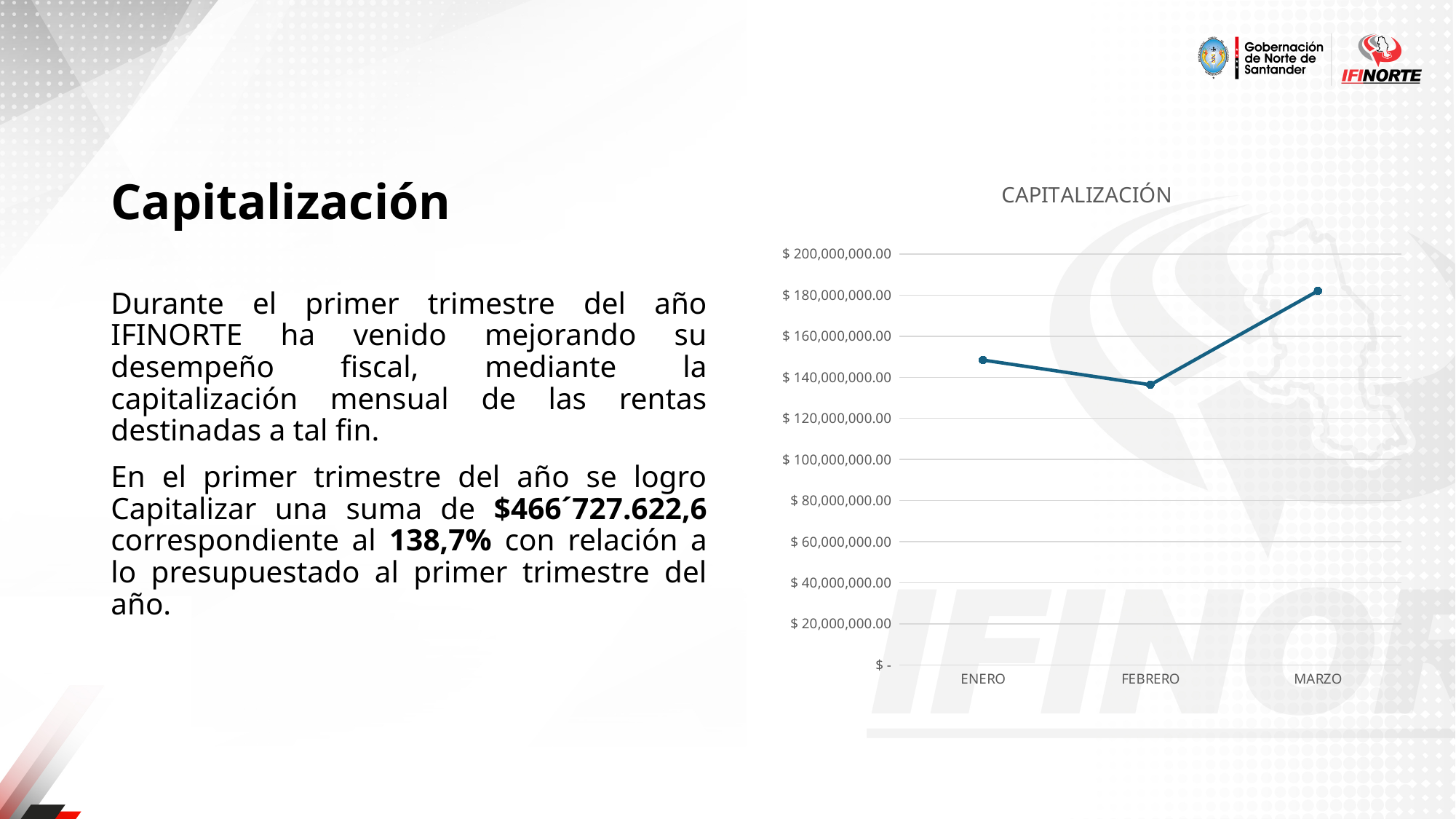
What is the title of the chart? CAPITALIZACIÓN Is the value for FEBRERO greater or less than $ 120,000,000.00? greater How many months are plotted on the x axis of the chart? 3 Is the value for ENERO greater or less than $ 140,000,000.00? greater Which month has the lowest value in the chart? FEBRERO Does the value rise or fall from ENERO to FEBRERO? fall Which is larger, the value for ENERO or the value for FEBRERO? ENERO Is the value for MARZO greater or less than $ 160,000,000.00? greater What kind of chart is shown on the slide? line chart Which month has the highest value in the chart? MARZO Which is larger, the value for MARZO or the value for ENERO? MARZO Does the value rise or fall from FEBRERO to MARZO? rise